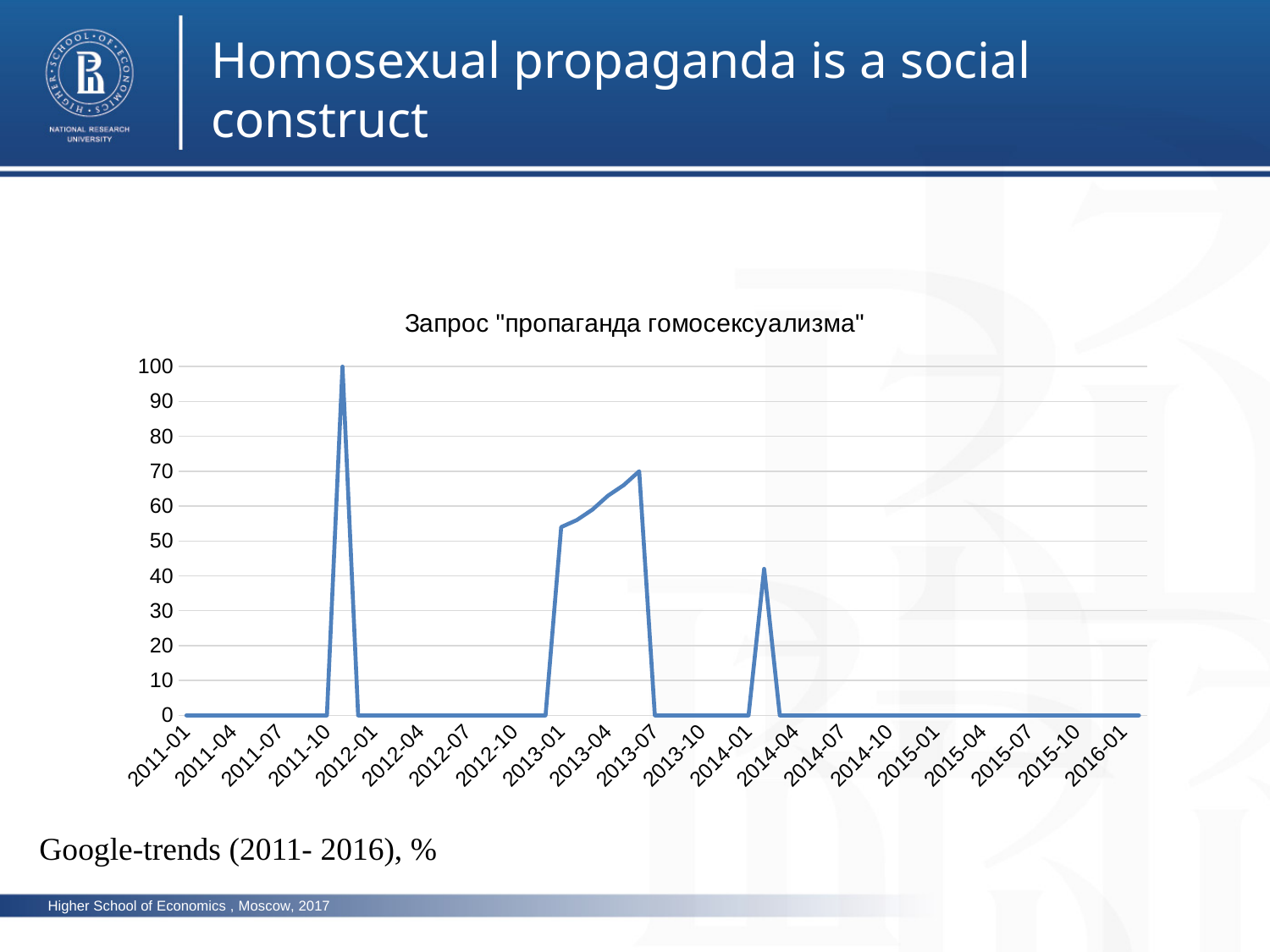
Is the value for 2013-01 greater or less than 40? greater What is the title of the chart? Запрос "пропаганда гомосексуализма" What is the value for 2011-01? 0 What is the highest value reached by the line on the chart? 100 What is the maximum value shown on the vertical axis? 100 Is the value for 2012-04 greater or less than 10? less Which has the larger value, 2013-04 or 2014-04? 2013-04 How many lines (series) are plotted on the chart? 1 Is the value for 2013-04 greater or less than 50? greater What kind of chart is shown on the slide? line chart What is the value for 2015-01? 0